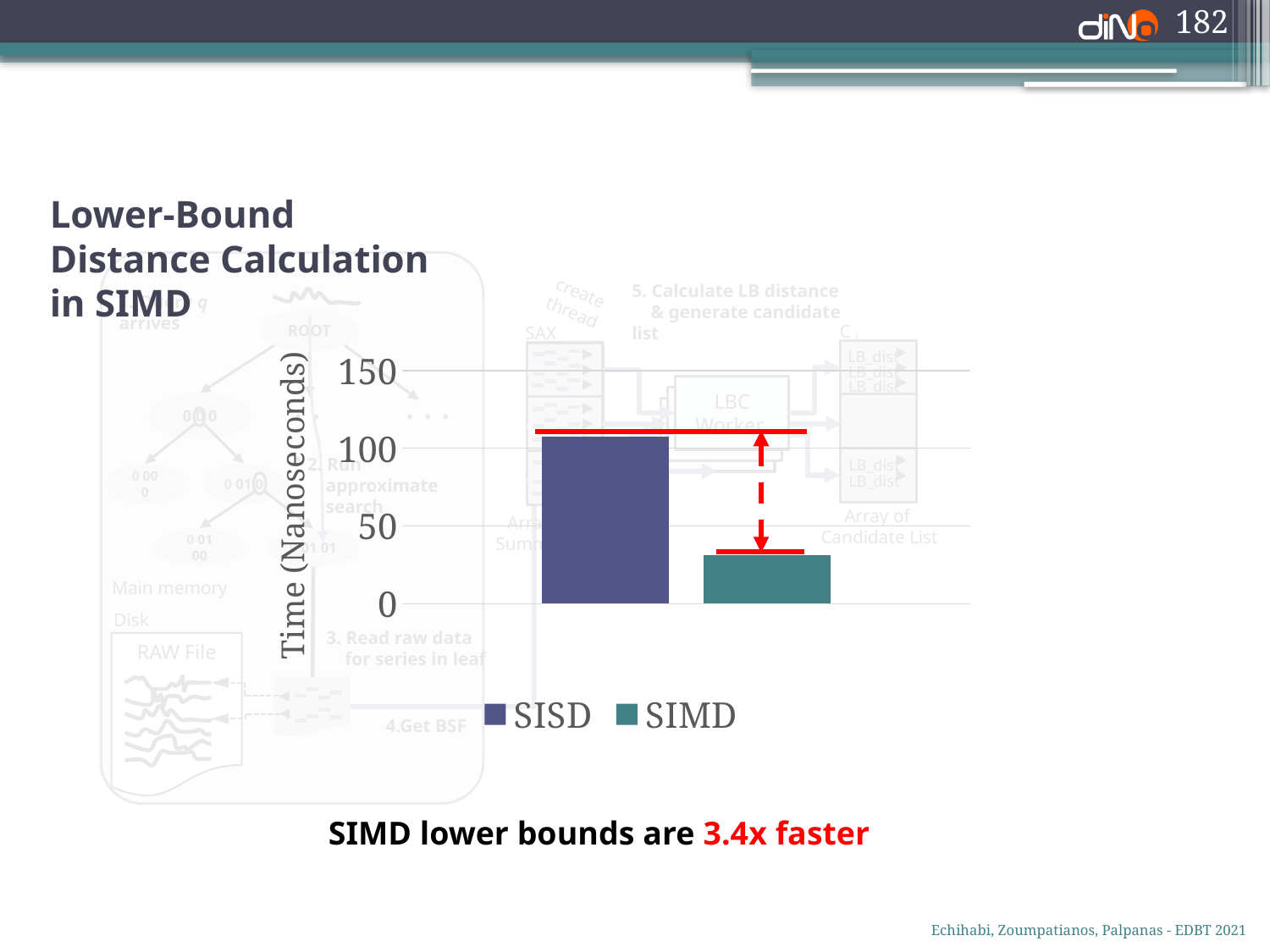
What are the two entries listed in the chart legend? SISD and SIMD What kind of chart is shown on the slide? bar chart How many bars are plotted in the chart? 2 Is the value for SIMD greater or less than 50? less Which series has the lowest time in the chart? SIMD Which series has the highest time in the chart? SISD How many series does the chart legend list? 2 Is the value for SISD greater or less than 100? greater What is the label of the vertical axis of the chart? Time (Nanoseconds) Is the value for SISD greater or less than 150? less Which is larger, the time for SISD or the time for SIMD? SISD